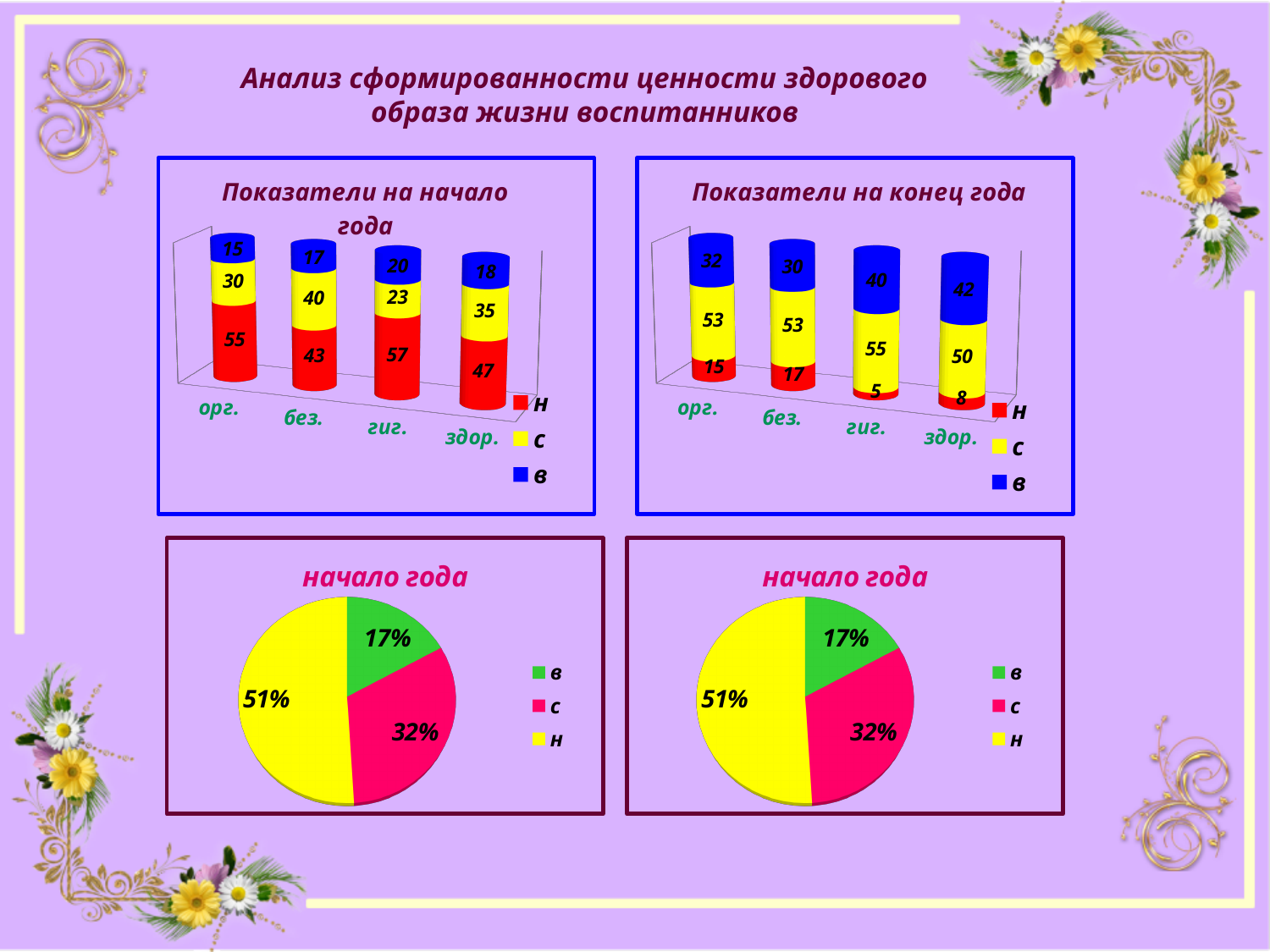
How many series does the legend list in the chart titled "Показатели на конец года"? 3 In the chart titled "Показатели на начало года", what is the total of the stacked bar for "здор."? 100 In the chart titled "Показатели на конец года", what is the value of the "в" series for "здор."? 42 In the bottom-left pie chart titled "начало года", what share does the "н" slice have? 51% What kind of chart is the bottom-left chart titled "начало года"? pie chart In the chart titled "Показатели на конец года", which category has the lowest value for the "н" series? гиг. In the chart titled "Показатели на конец года", what is the difference between the "с" values for "гиг." and "орг."? 2 How many categories are shown on the x axis of the chart titled "Показатели на начало года"? 4 In the chart titled "Показатели на начало года", which category has the highest value for the "в" series? гиг. In the chart titled "Показатели на начало года", what is the value of the "н" series for "орг."? 55 In the chart titled "Показатели на начало года", what is the value of the "с" series for "без."? 40 In the chart titled "Показатели на конец года", which is larger: the "в" value for "орг." or the "в" value for "без."? орг.